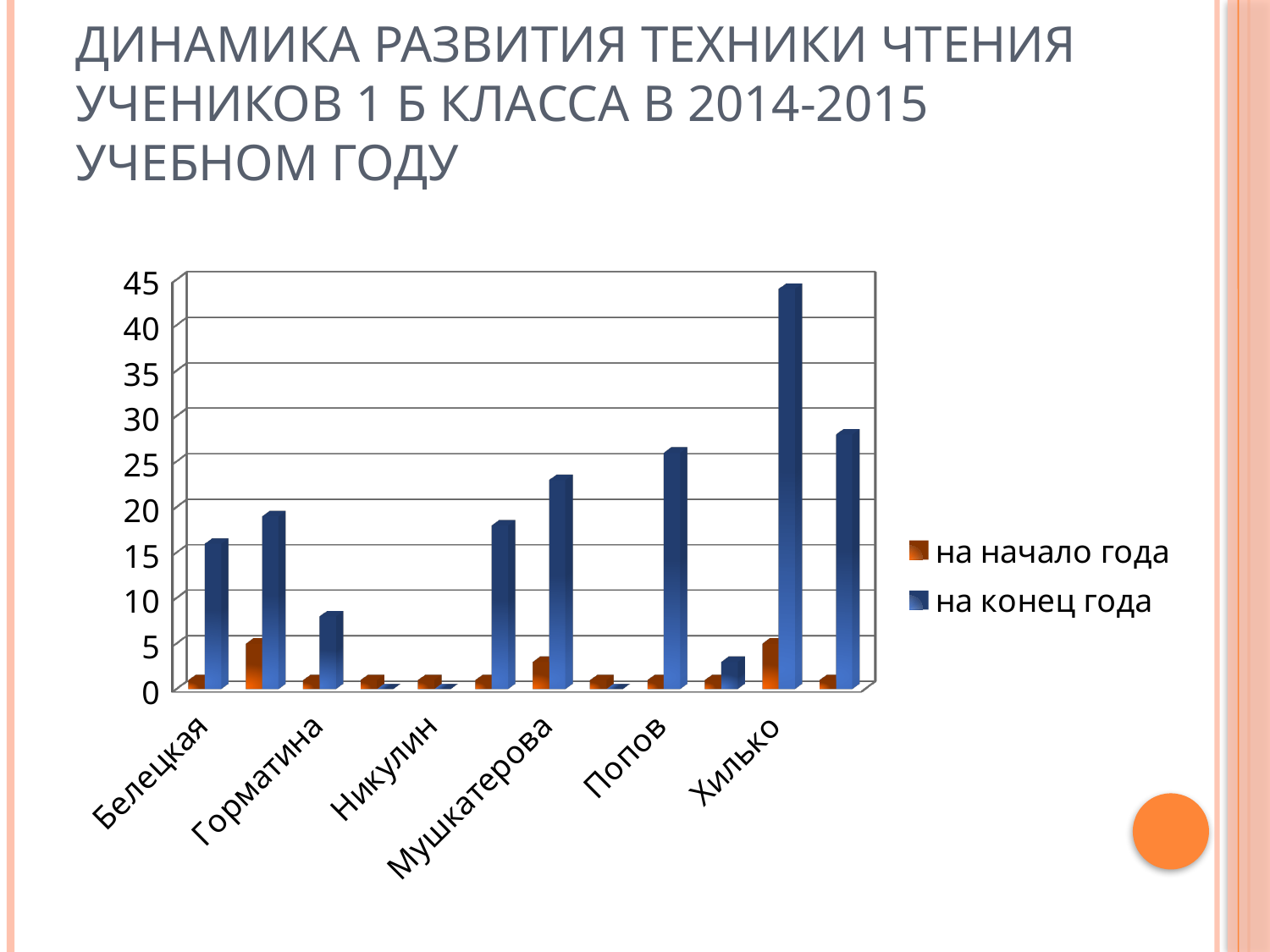
Is the 'на конец года' value for Попов greater or less than 20? greater Which is larger for 'на конец года': Хилько or Попов? Хилько What kind of chart is shown on the slide? bar chart Which is larger for 'на конец года': Мушкатерова or Горматина? Мушкатерова Is the 'на конец года' value for Хилько greater or less than 40? greater Which series is shown in blue? на конец года Is the 'на конец года' value for Горматина greater or less than 10? less How many series does the legend list? 2 Which series is shown in orange? на начало года Which student has the highest value for 'на конец года'? Хилько